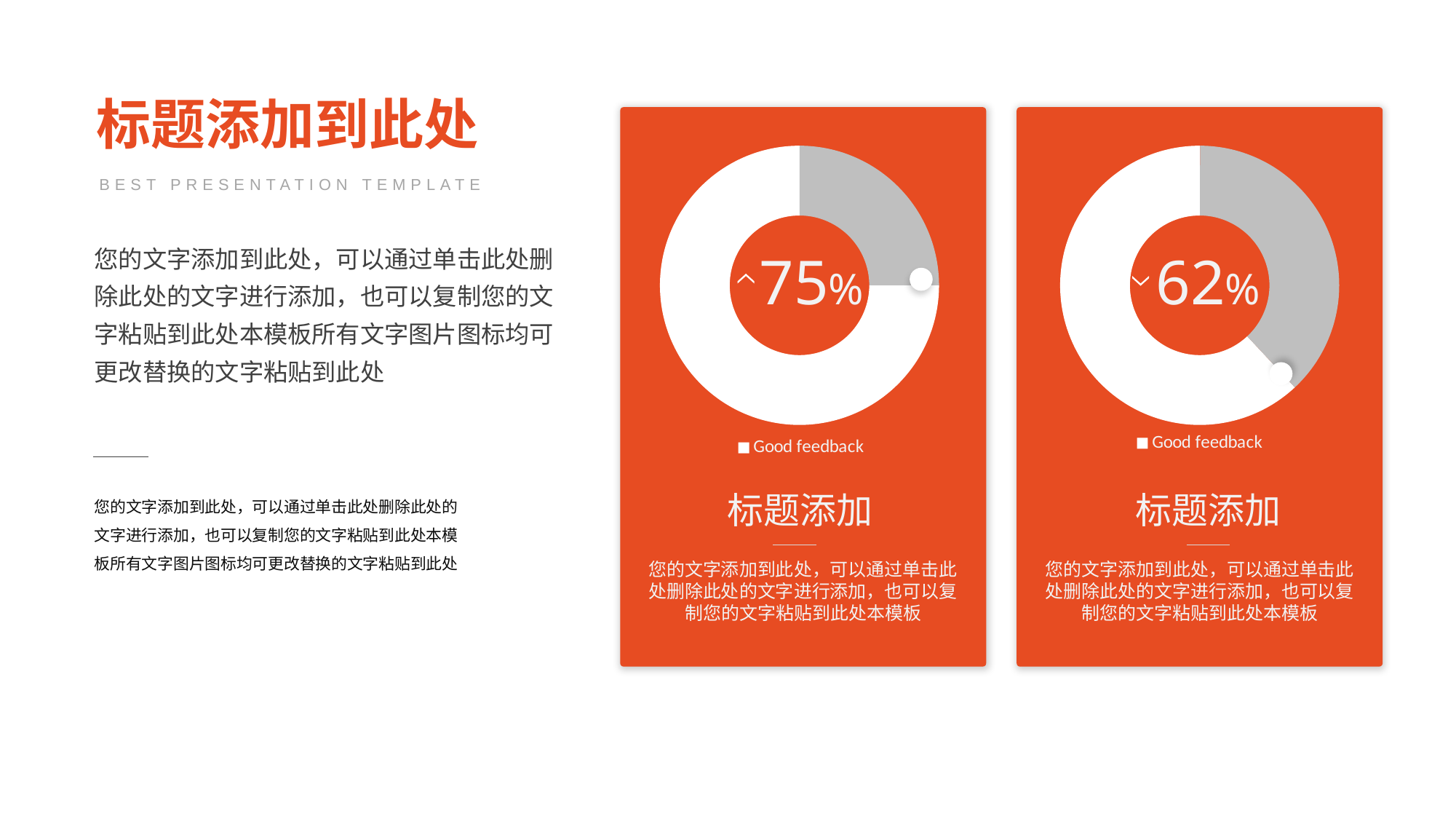
What is the legend entry shown under the right donut chart? Good feedback What percentage is shown in the centre of the left donut chart? 75% Which of the two donut charts shows the higher percentage, the left one or the right one? the left one Is the value shown on the right donut chart greater or less than 50%? greater How many entries does the legend under the left donut chart list? 1 What is the difference in percentage points between the value on the left donut chart and the value on the right donut chart? 13 What kind of chart is shown on the right card? donut chart What percentage is shown in the centre of the right donut chart? 62% How many donut charts are on the slide? 2 What colour is the background of the cards containing the two donut charts? orange Which donut chart shows the lower percentage, the left one or the right one? the right one What kind of chart is shown on the left card? donut chart